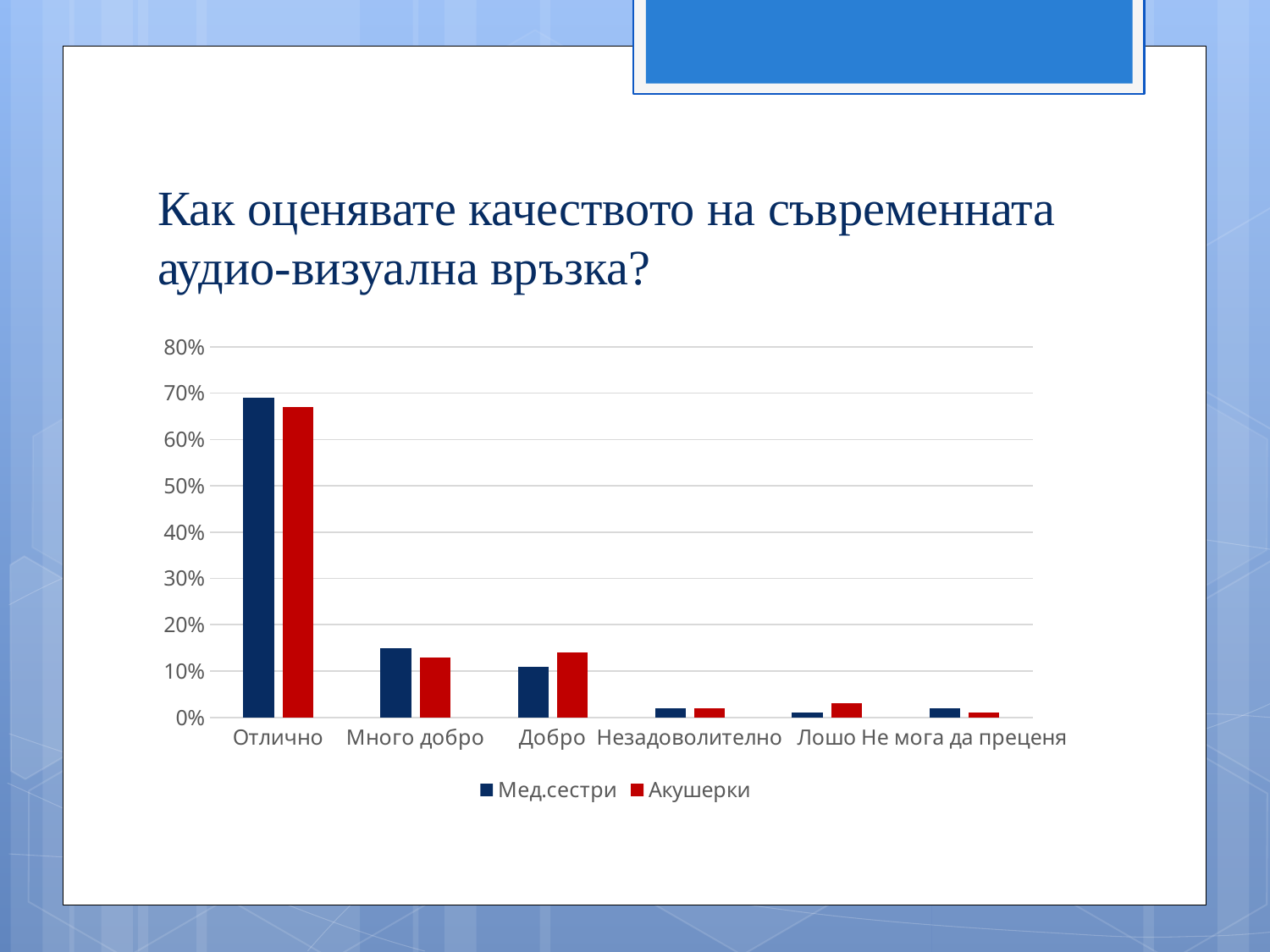
Which category has the highest value for Акушерки? Отлично Which category has the highest value for Мед.сестри? Отлично How many series does the chart legend list? 2 Is the value for Мед.сестри in the Много добро category greater or less than 10%? greater In the Добро category, which series has the larger value, Мед.сестри or Акушерки? Акушерки How many categories are shown on the x axis of the chart? 6 Is the value for Акушерки in the Отлично category greater or less than 50%? greater In the Много добро category, which series has the larger value, Мед.сестри or Акушерки? Мед.сестри Is the value for Мед.сестри in the Отлично category greater or less than 60%? greater What kind of chart is shown on the slide? bar chart Which colour represents the Акушерки series in the chart? red